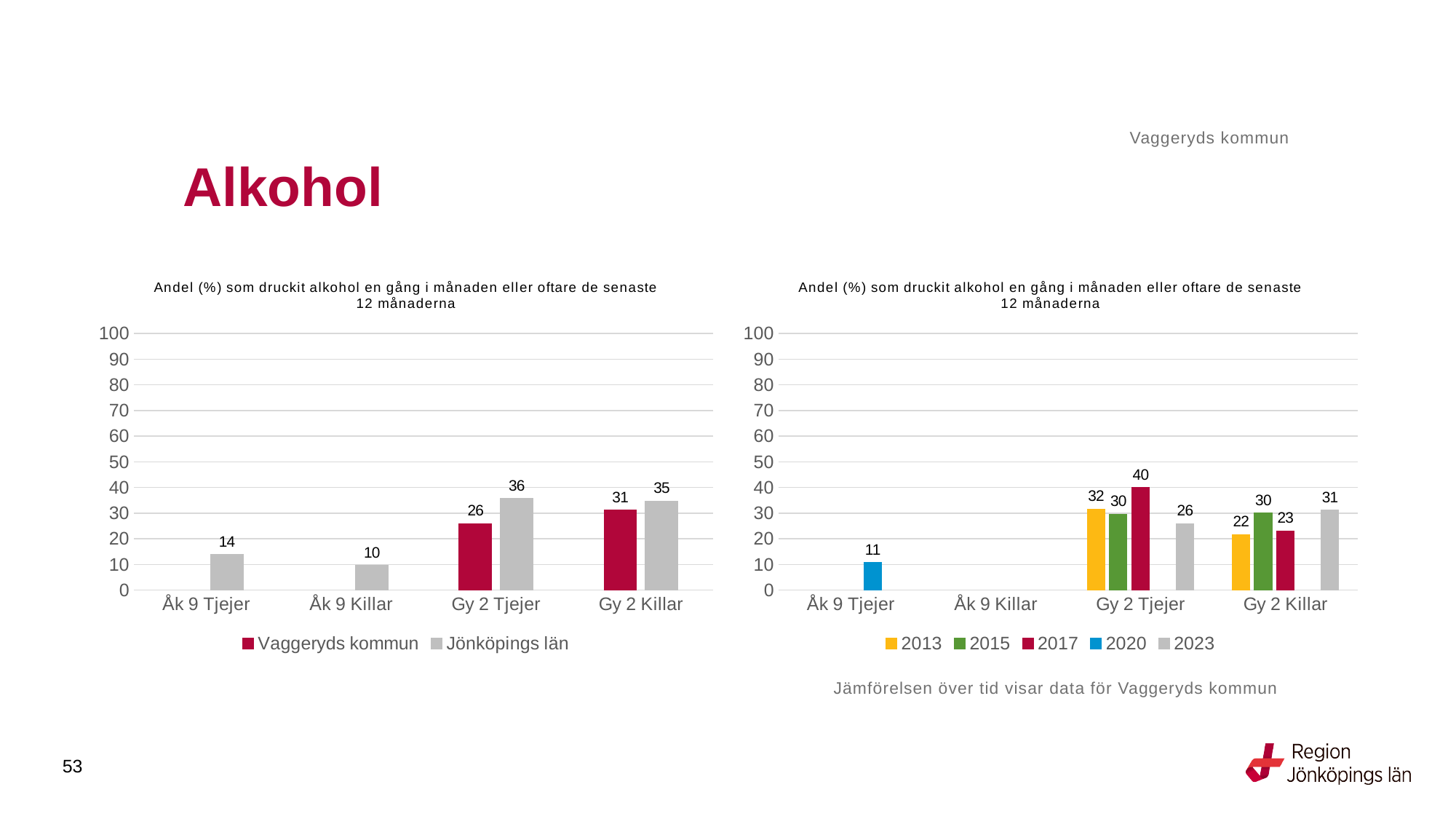
In the right chart, what is the value for 2020 for Åk 9 Tjejer? 11 In the right chart, is the value for 2013 or 2023 larger for Gy 2 Tjejer? 2013 In the left chart, what is the value for Vaggeryds kommun for Gy 2 Killar? 31 In the right chart, what is the value for 2017 for Gy 2 Tjejer? 40 In the left chart, what is the difference between Jönköpings län and Vaggeryds kommun for Gy 2 Tjejer? 10 What kind of chart is the left chart? Bar chart In the right chart, what is the difference between 2017 and 2023 for Gy 2 Tjejer? 14 In the left chart, what is the value for Jönköpings län for Gy 2 Tjejer? 36 In the right chart, how many series does the legend list? 5 In the left chart, how many series does the legend list? 2 In the left chart, which category has the lowest value for Jönköpings län? Åk 9 Killar In the right chart, which year has the highest value for Gy 2 Killar? 2023